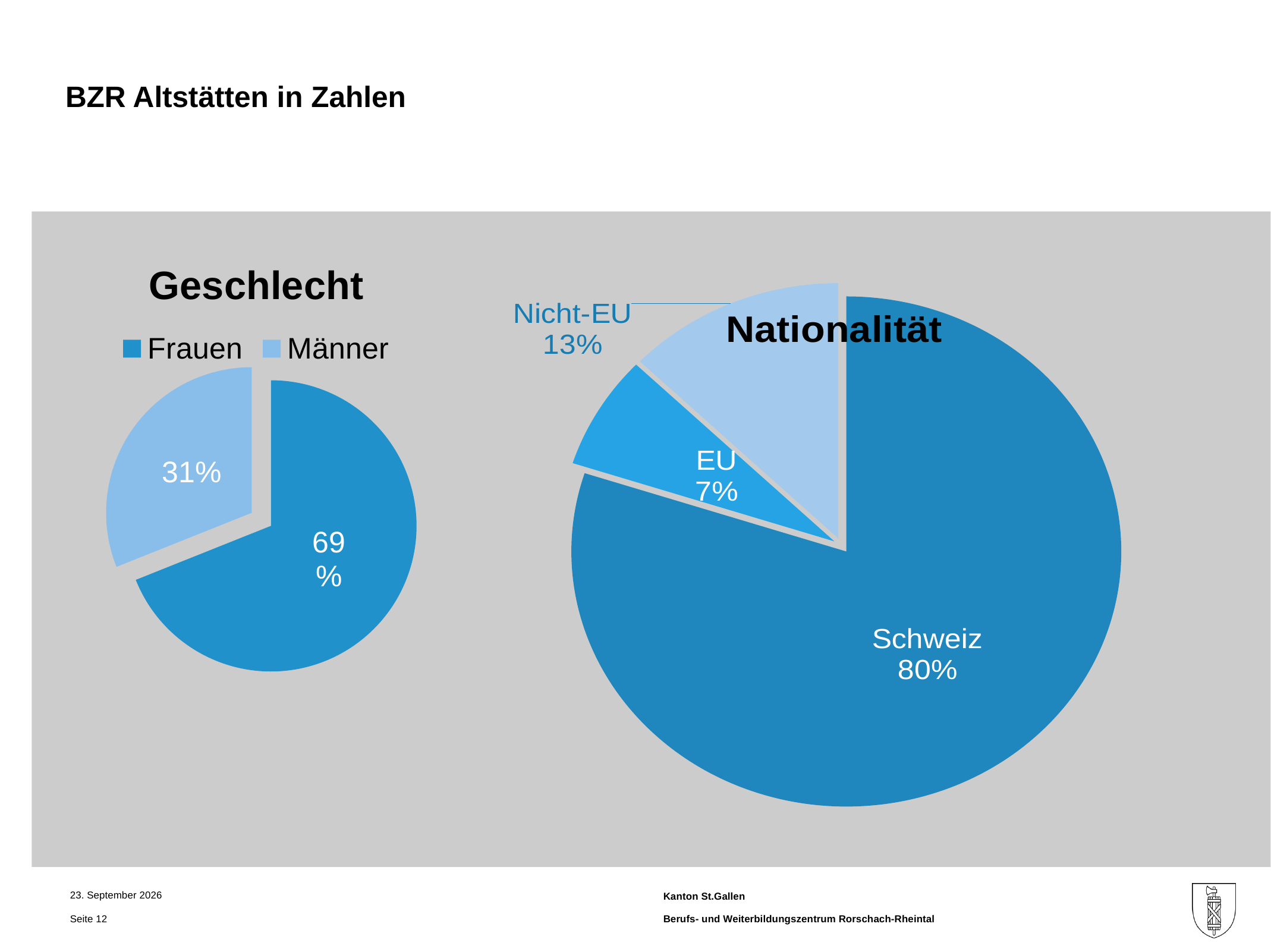
In the "Nationalität" chart, what share is shown for Schweiz? 80% How many slices does the "Nationalität" chart have? 3 In the "Geschlecht" chart, what is the difference in percentage points between the Frauen and Männer shares? 38 How many entries does the legend of the "Geschlecht" chart list? 2 What kind of chart is the "Geschlecht" chart? Pie chart In the "Geschlecht" chart, which group has the larger share, Frauen or Männer? Frauen In the "Nationalität" chart, which category has the smallest share? EU In the "Nationalität" chart, what is the difference in percentage points between the Nicht-EU and EU shares? 6 In the "Nationalität" chart, what share is shown for EU? 7% In the "Geschlecht" chart, what share is shown for Männer? 31% In the "Nationalität" chart, what share is shown for Nicht-EU? 13% In the "Geschlecht" chart, what share is shown for Frauen? 69%